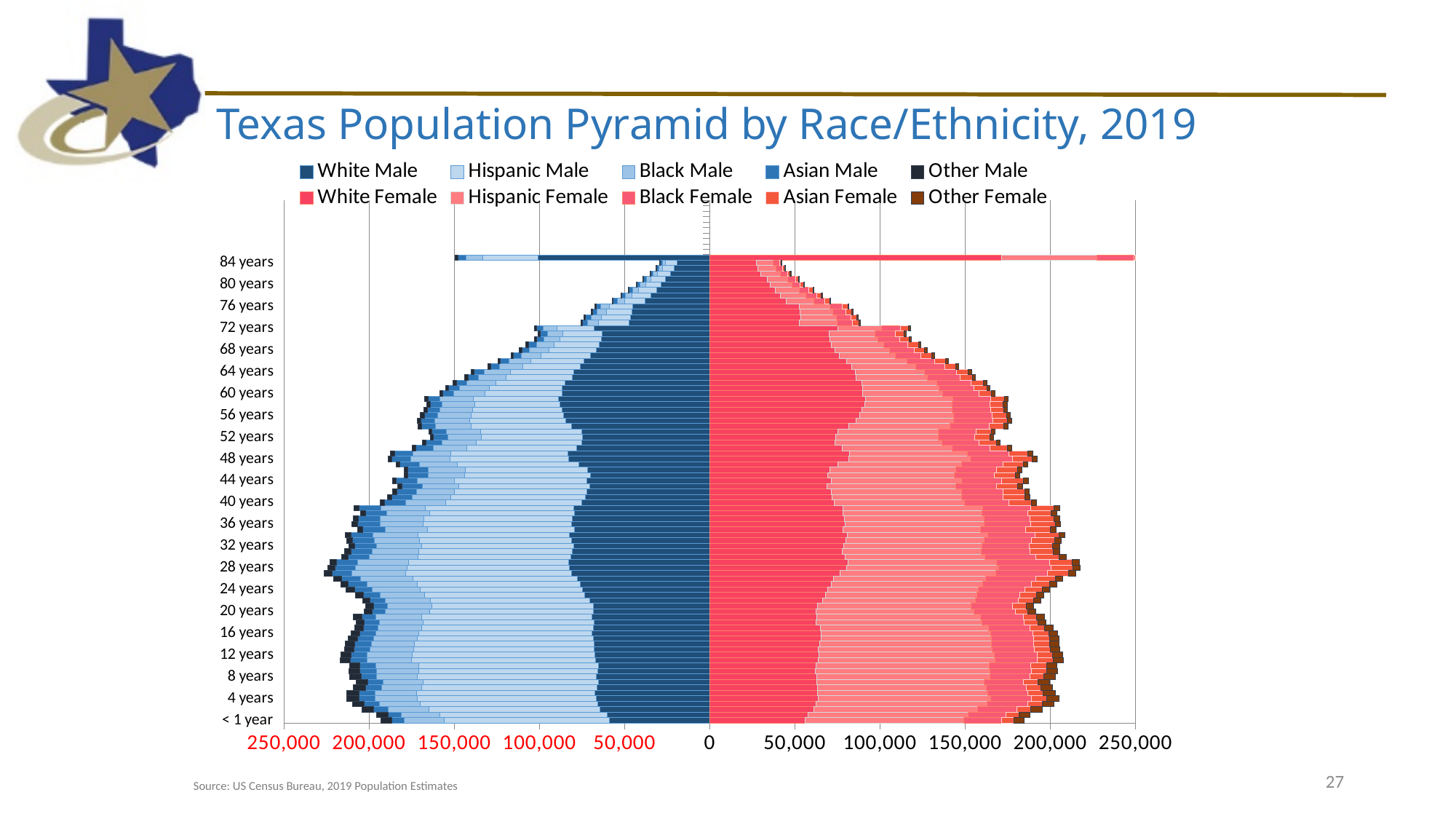
Is the total male bar for 84 years greater or less than 100,000? less Is the total male bar for 72 years greater or less than 150,000? less Is the total male bar for 28 years greater or less than 200,000? greater Which is larger at 84 years, the total male bar or the total female bar? Female Which side of the chart shows the male population bars? Left What type of chart is shown on the slide? Bar chart (population pyramid) What is the title of the chart? Texas Population Pyramid by Race/Ethnicity, 2019 Do the total bars get longer or shorter moving from 60 years up to 80 years? Shorter How many series does the legend list? 10